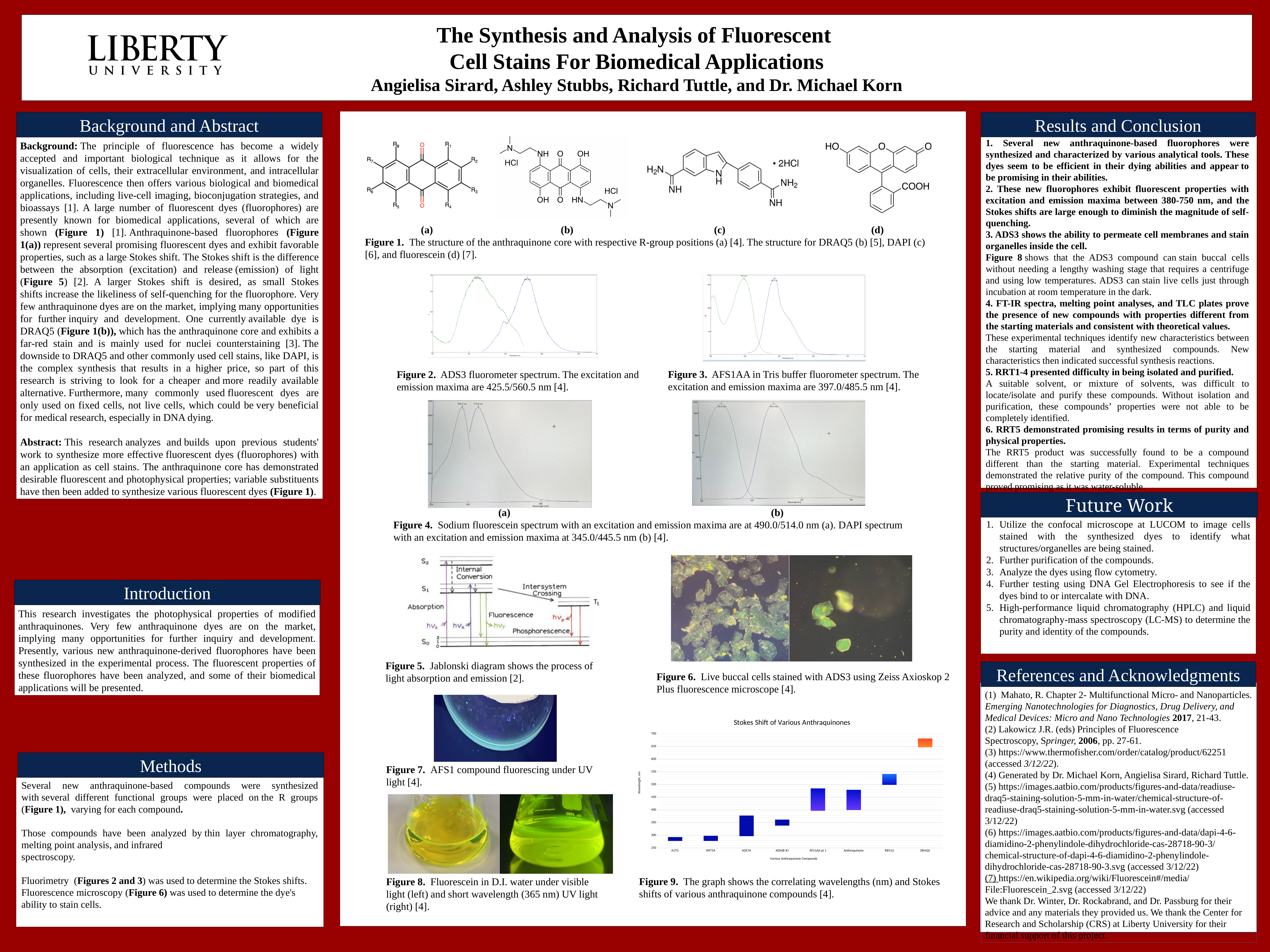
In the "Stokes Shift of Various Anthraquinones" chart, do the values generally rise or fall from left to right along the x axis? rise What is the x-axis label of the "Stokes Shift of Various Anthraquinones" chart? Various Anthraquinone Compounds In the "Stokes Shift of Various Anthraquinones" chart, is the value for DRAQ5 greater or less than 600? greater In the "Stokes Shift of Various Anthraquinones" chart, which has the larger values, RBS1U or ADS7A? RBS1U In the "Stokes Shift of Various Anthraquinones" chart, which has the larger values, DRAQ5 or A1TG? DRAQ5 In the "Stokes Shift of Various Anthraquinones" chart, which compound has the highest wavelength values? DRAQ5 In the "Stokes Shift of Various Anthraquinones" chart, how many compounds are plotted along the x axis? 8 In the "Stokes Shift of Various Anthraquinones" chart, is the value for A1TG greater or less than 300? less In the chart titled "Stokes Shift of Various Anthraquinones" (Figure 9), what kind of chart is shown? bar chart What is the y-axis label of the "Stokes Shift of Various Anthraquinones" chart? Wavelength, nm